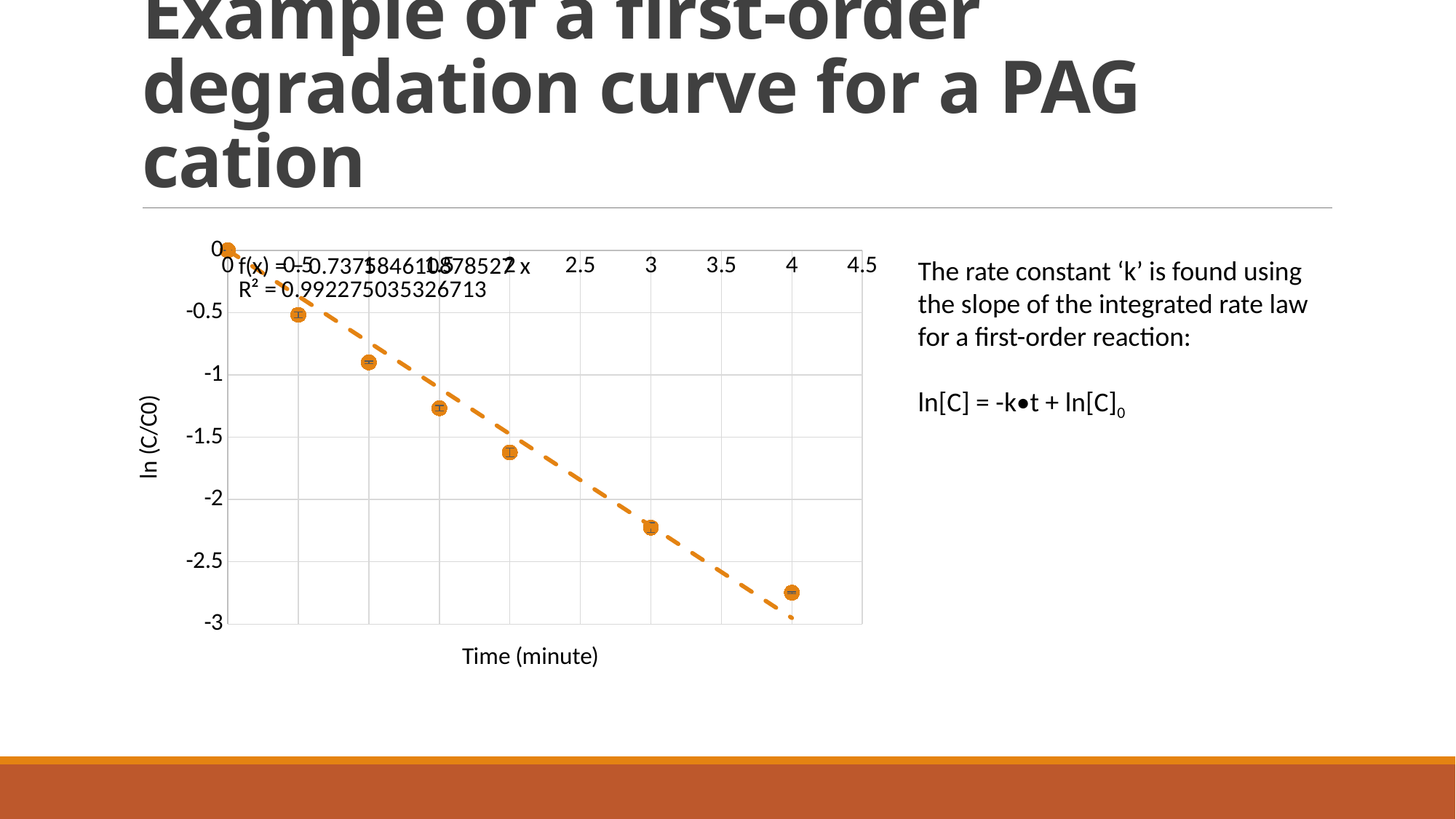
Which has the larger ln (C/C0) value: the point at time 1 or the point at time 3? time 1 Is the ln (C/C0) value at time 4 greater or less than -3? greater Do the plotted values rise or fall as time increases along the x axis? fall At which time (minute) is the plotted ln (C/C0) value lowest? 4 How many data points are plotted on the chart? 7 Is the ln (C/C0) value at time 1 greater or less than -1? greater Is the ln (C/C0) value at time 3 greater or less than -2? less At which time (minute) is the plotted ln (C/C0) value highest? 0 What is the title of the x axis of the chart? Time (minute) What kind of chart is shown on the slide? scatter chart What is the ln (C/C0) value plotted at time 0? 0